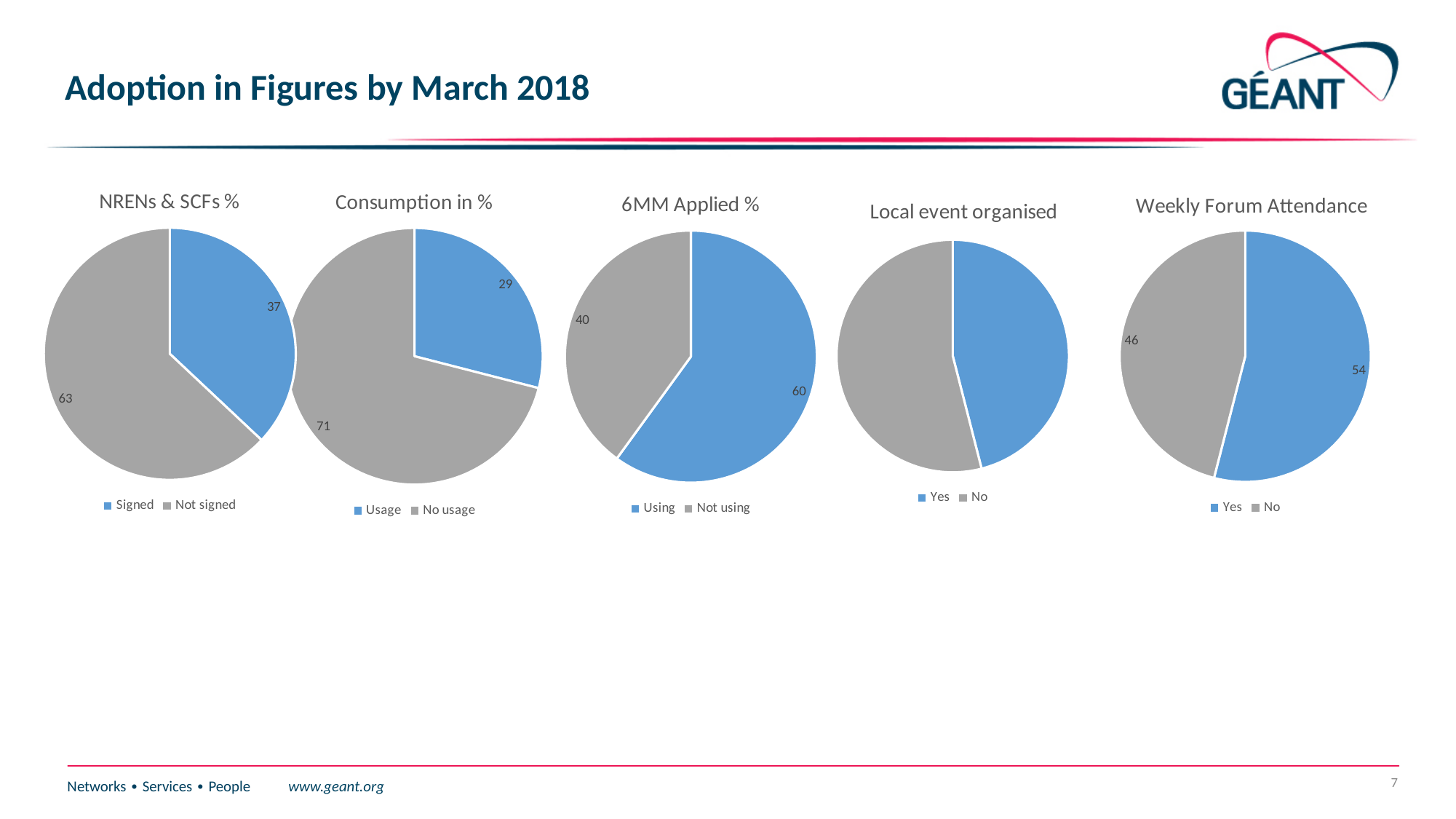
In the '6MM Applied %' chart, which slice is larger, Using or Not using? Using In the '6MM Applied %' chart, what is the value for Using? 60 In the 'NRENs & SCFs %' chart, what is the value for Signed? 37 In the 'NRENs & SCFs %' chart, what is the value for Not signed? 63 In the 'Weekly Forum Attendance' chart, what is the difference between Yes and No? 8 How many slices does the 'NRENs & SCFs %' chart have? 2 In the 'Consumption in %' chart, what is the difference between No usage and Usage? 42 In the 'Local event organised' chart, which slice is larger, Yes or No? No What are the legend entries of the 'Local event organised' chart? Yes, No In the 'Weekly Forum Attendance' chart, what is the value for No? 46 What type of chart is the 'Consumption in %' chart? Pie chart In the 'Consumption in %' chart, what is the value for No usage? 71